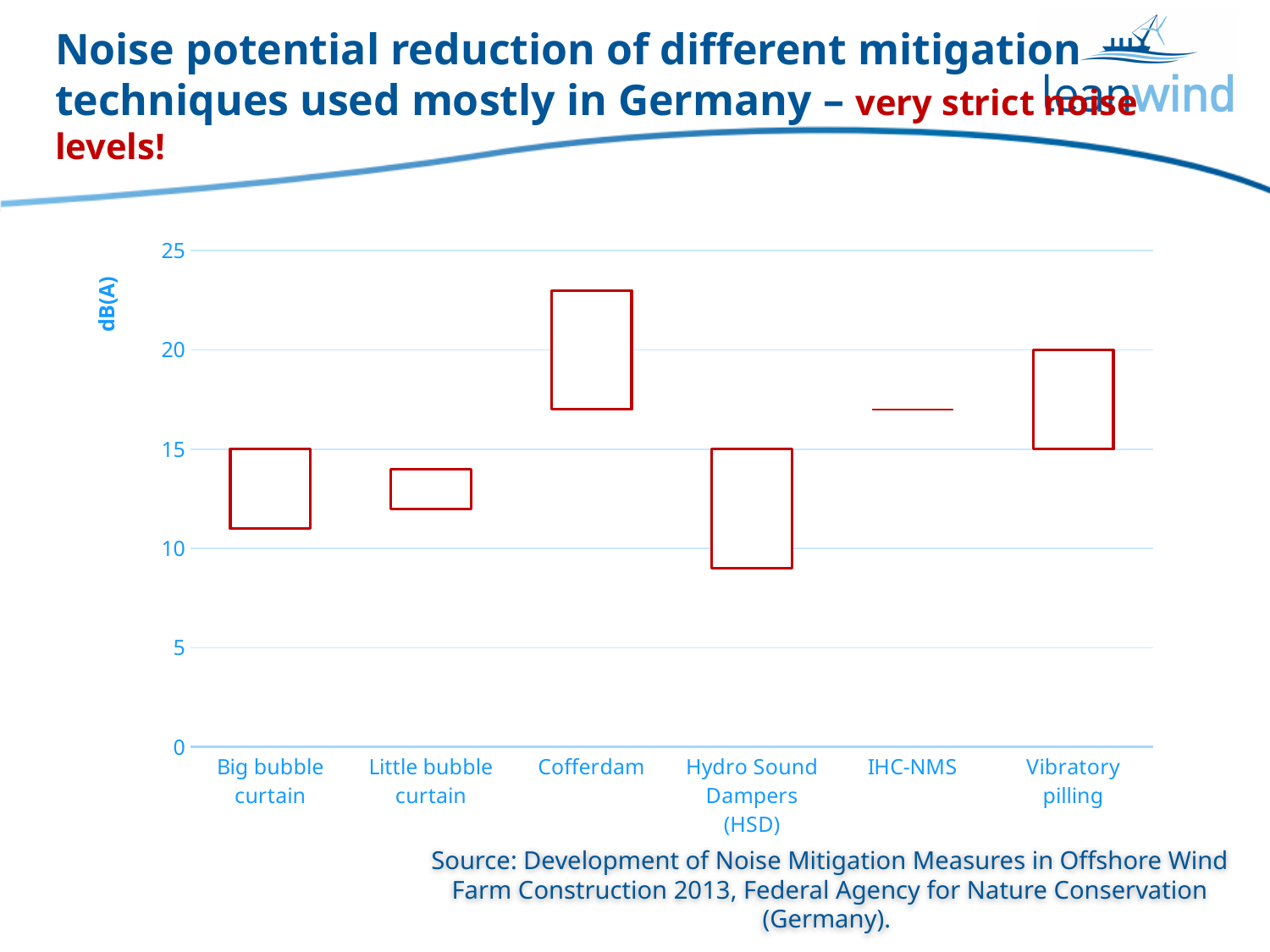
What is the upper end of the noise reduction range for Vibratory pilling, in dB(A)? 20 Is the value shown for IHC-NMS greater or less than 15 dB(A)? greater How many mitigation techniques are shown on the x axis of the chart? 6 Is the lower end of the Hydro Sound Dampers (HSD) range greater or less than 10 dB(A)? less Which mitigation technique reaches the highest noise reduction value in dB(A)? Cofferdam What is the upper end of the noise reduction range for Big bubble curtain, in dB(A)? 15 What is the lower end of the noise reduction range for Vibratory pilling, in dB(A)? 15 Is the upper end of the Cofferdam range greater or less than 20 dB(A)? greater What is the label on the vertical axis of the chart? dB(A) What kind of chart is used to show the noise reduction ranges? bar chart Which mitigation technique has the lowest bottom end of its noise reduction range? Hydro Sound Dampers (HSD) Which has a higher upper end of its range: Cofferdam or Vibratory pilling? Cofferdam